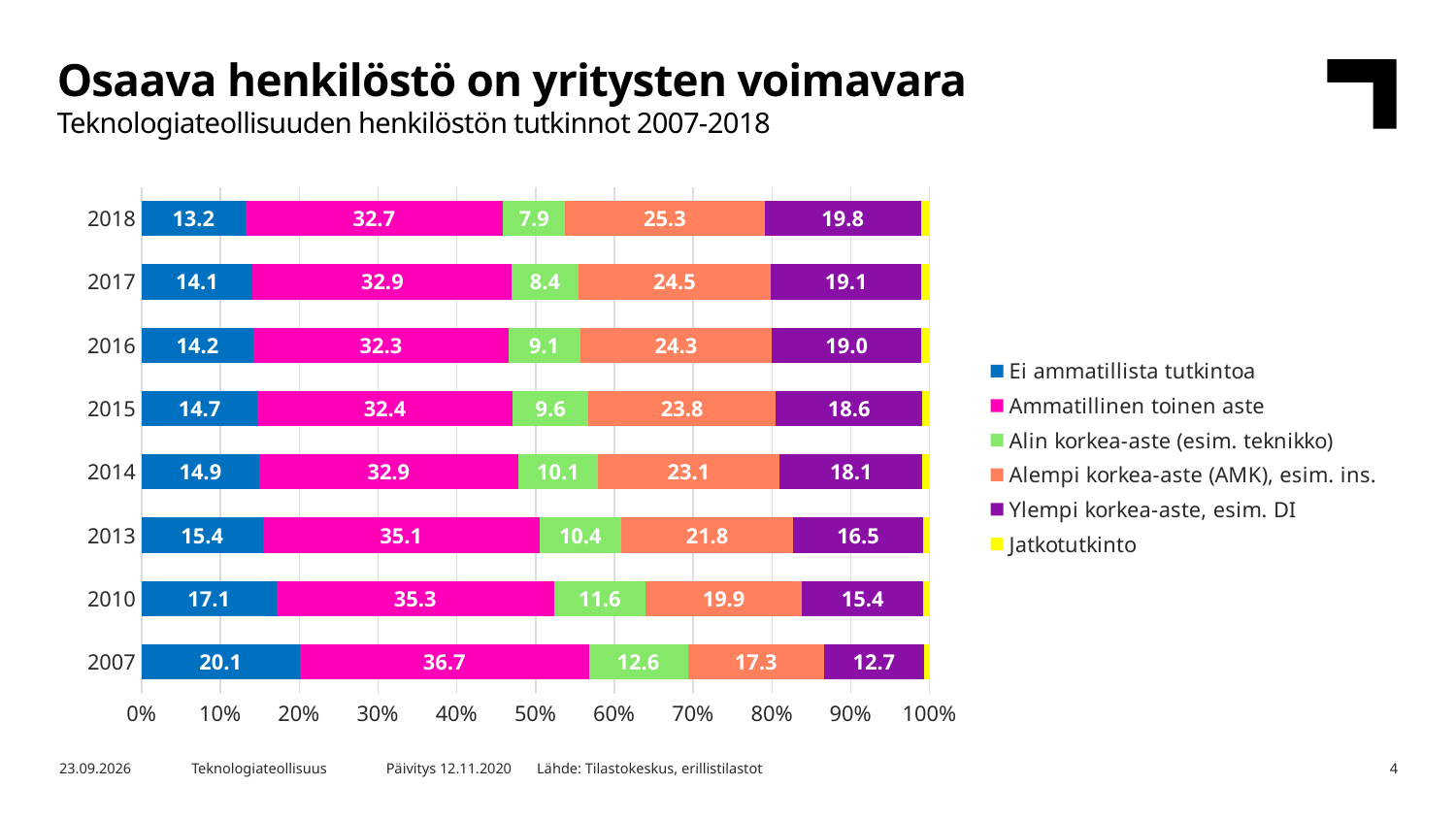
In which year is the value for "Ei ammatillista tutkintoa" highest? 2007 What is the value for "Alempi korkea-aste (AMK), esim. ins." in 2013? 21.8 How many series does the legend list? 6 How many years are shown on the chart? 8 In which year is the value for "Ylempi korkea-aste, esim. DI" lowest? 2007 What is the value for "Ammatillinen toinen aste" in 2007? 36.7 What is the value for "Ei ammatillista tutkintoa" in 2018? 13.2 What is the value for "Ylempi korkea-aste, esim. DI" in 2014? 18.1 Does the value for "Ylempi korkea-aste, esim. DI" rise or fall from 2007 to 2018? Rise What kind of chart is shown on the slide? Stacked bar chart Which is larger: the "Alin korkea-aste (esim. teknikko)" value for 2010 or for 2018? 2010 What is the difference between the "Alempi korkea-aste (AMK), esim. ins." values for 2018 and 2007? 8.0